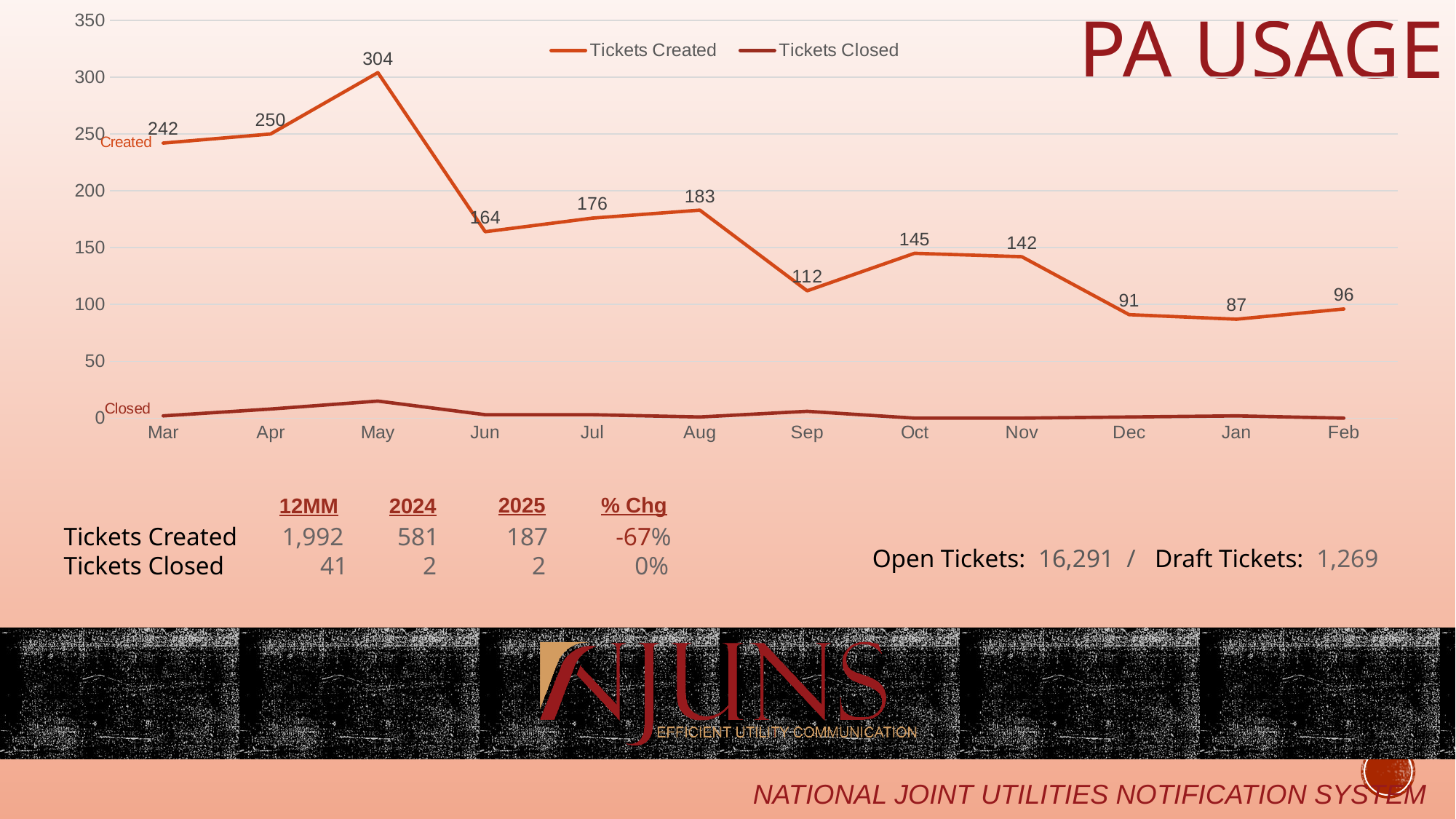
Which month has the lowest value for Tickets Created? Jan How many months are shown on the x axis? 12 Which is larger, Tickets Created in Aug or in Oct? Aug Does the Tickets Created line generally rise or fall from May to Feb? fall Is the value for Tickets Closed in May greater or less than 50? less Which month has the highest value for Tickets Created? May What is the title of the slide containing the chart? PA USAGE How many series does the legend list? 2 What kind of chart is shown on the slide? line chart What is the value of Tickets Created in Sep? 112 What is the value of Tickets Created in May? 304 What is the difference between Tickets Created in May and Jun? 140